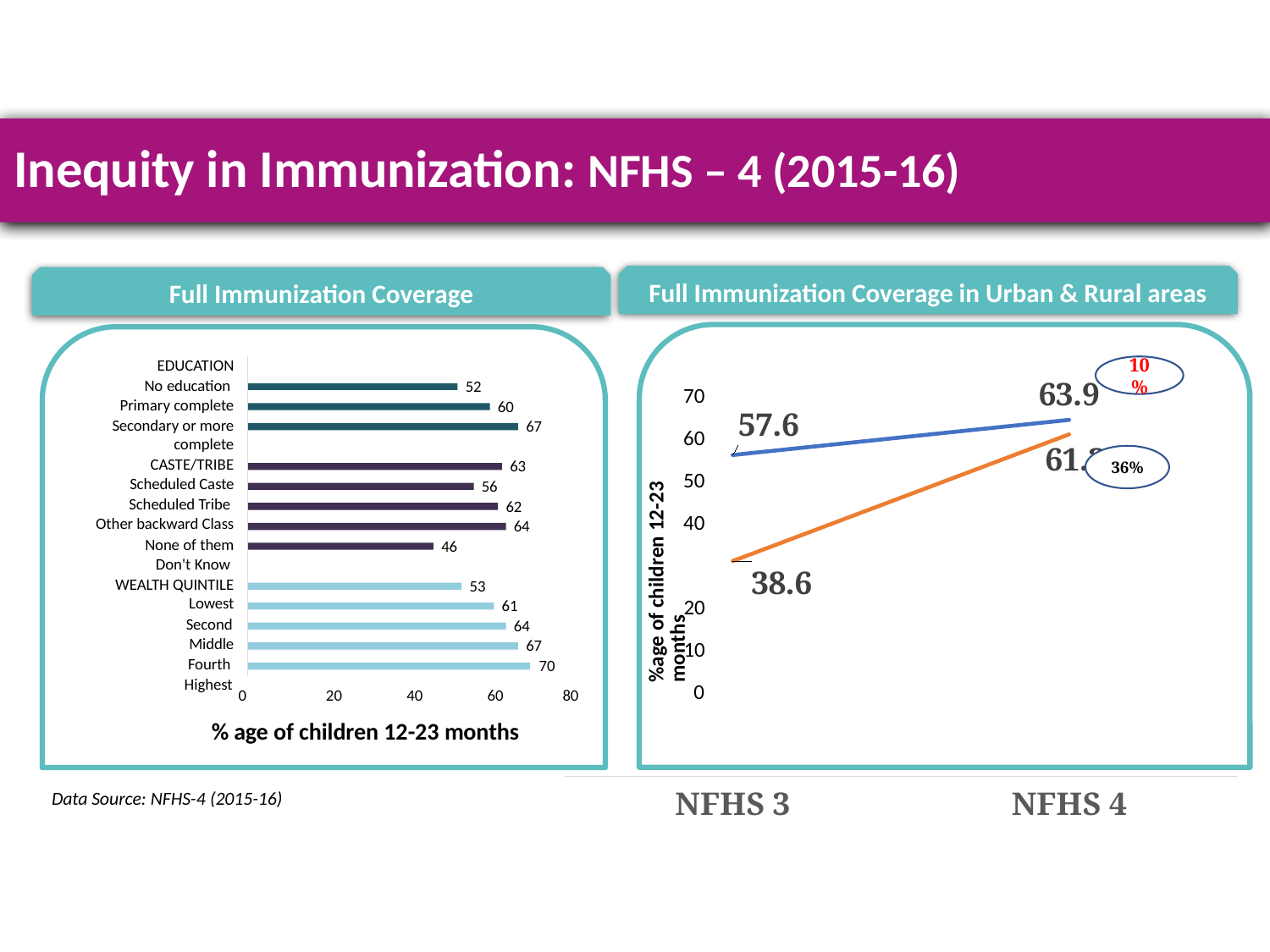
In the 'Full Immunization Coverage' chart, what is the largest value shown on any bar? 70 In the 'Full Immunization Coverage' chart, what is the value for 'Secondary or more complete'? 67 In the 'Full Immunization Coverage' chart, what is the smallest value shown on any bar? 46 In the 'Full Immunization Coverage' chart, what is the value for 'No education'? 52 In the 'Full Immunization Coverage in Urban & Rural areas' chart, what is the value of the upper (blue) line at NFHS 3? 57.6 In the 'Full Immunization Coverage' chart, what is the difference between the values for 'Secondary or more complete' and 'No education'? 15 What kind of chart is the 'Full Immunization Coverage' chart on the left? bar chart In the 'Full Immunization Coverage' chart, what is the value for 'Primary complete'? 60 In the 'Full Immunization Coverage' chart, is the value for 'No education' greater or less than 60? less In the 'Full Immunization Coverage in Urban & Rural areas' chart, do the values rise or fall from NFHS 3 to NFHS 4? rise What is the x-axis title of the 'Full Immunization Coverage' chart? % age of children 12-23 months In the 'Full Immunization Coverage in Urban & Rural areas' chart, what is the value of the lower (orange) line at NFHS 3? 38.6